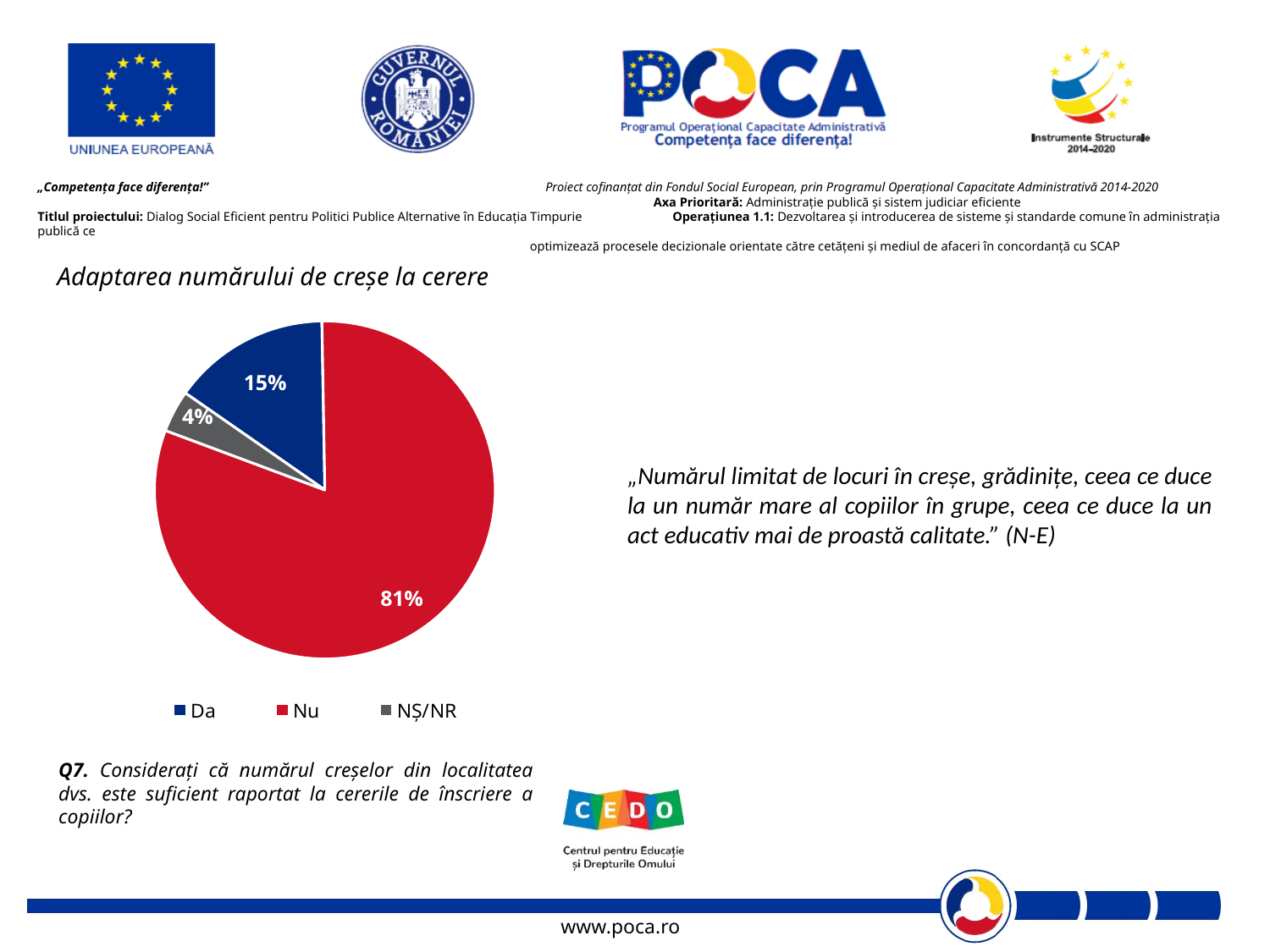
Which response has the largest share of the pie? Nu What percentage of respondents answered "Nu"? 81% What colour is the "Nu" slice in the pie chart? red What percentage of respondents answered "NȘ/NR"? 4% What percentage of respondents answered "Da"? 15% What is the difference in percentage points between the "Nu" and "Da" slices? 66 Which is larger, the share for "Da" or the share for "NȘ/NR"? Da What is the title shown above the pie chart? Adaptarea numărului de creșe la cerere Which response has the smallest share of the pie? NȘ/NR What kind of chart is shown on the slide? pie chart How many entries does the legend list? 3 How many categories does the pie chart show? 3